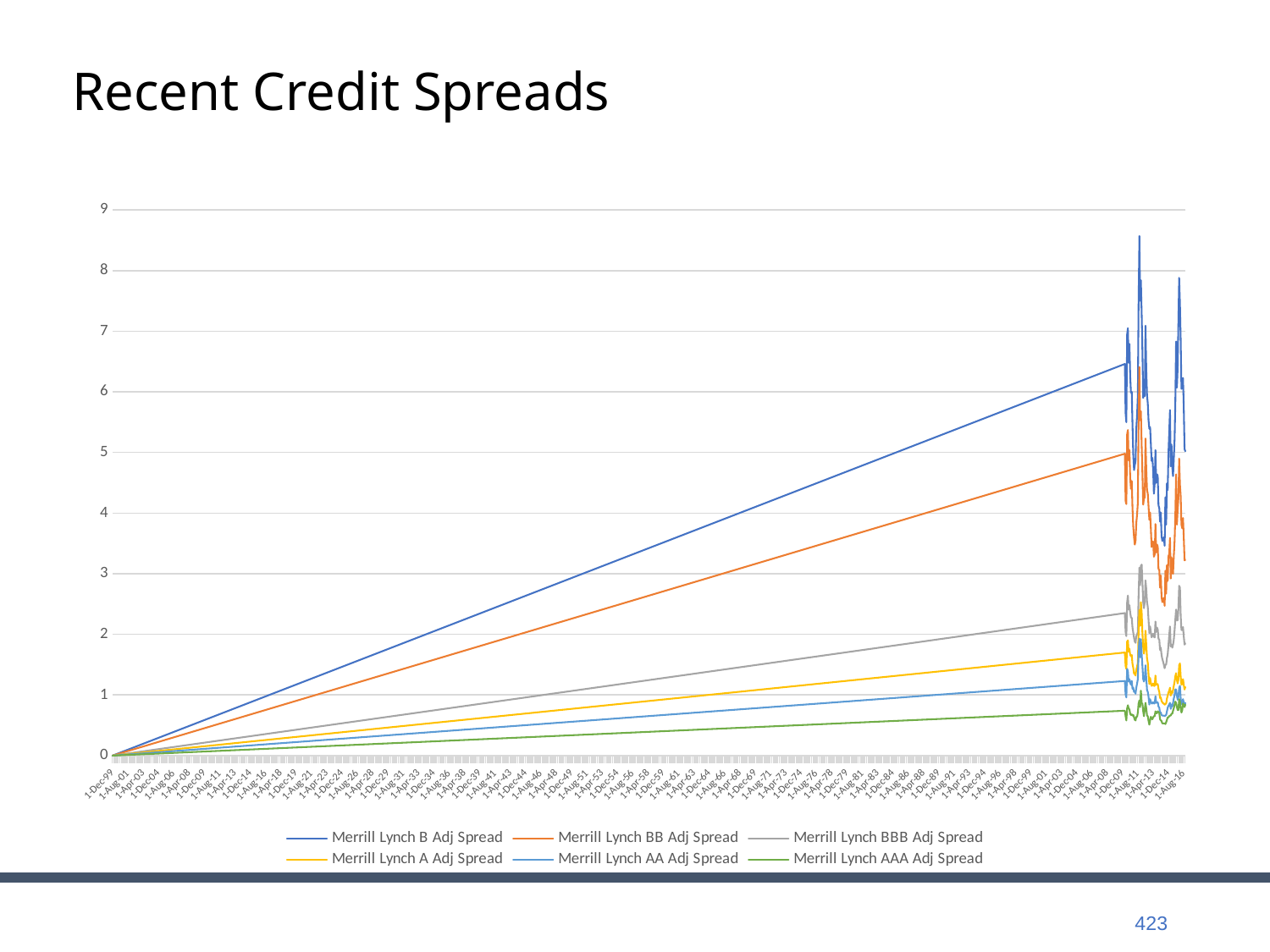
What colour is the Merrill Lynch BB Adj Spread line in the legend? orange Which series reaches the highest value on the chart? Merrill Lynch B Adj Spread Is the peak value of the Merrill Lynch A Adj Spread line greater or less than 2? greater Which is higher at the right end of the chart, the Merrill Lynch BB Adj Spread line or the Merrill Lynch BBB Adj Spread line? Merrill Lynch BB Adj Spread Does the Merrill Lynch B Adj Spread line rise or fall from the left edge of the chart to around 1-Dec-09? rise Is the peak value of the Merrill Lynch BBB Adj Spread line greater or less than 2? greater Is the peak value of the Merrill Lynch BB Adj Spread line greater or less than 4? greater What is the title of the slide's chart? Recent Credit Spreads What kind of chart is shown on the slide? line chart How many series does the legend list? 6 Which is higher at the right end of the chart, the Merrill Lynch B Adj Spread line or the Merrill Lynch AAA Adj Spread line? Merrill Lynch B Adj Spread